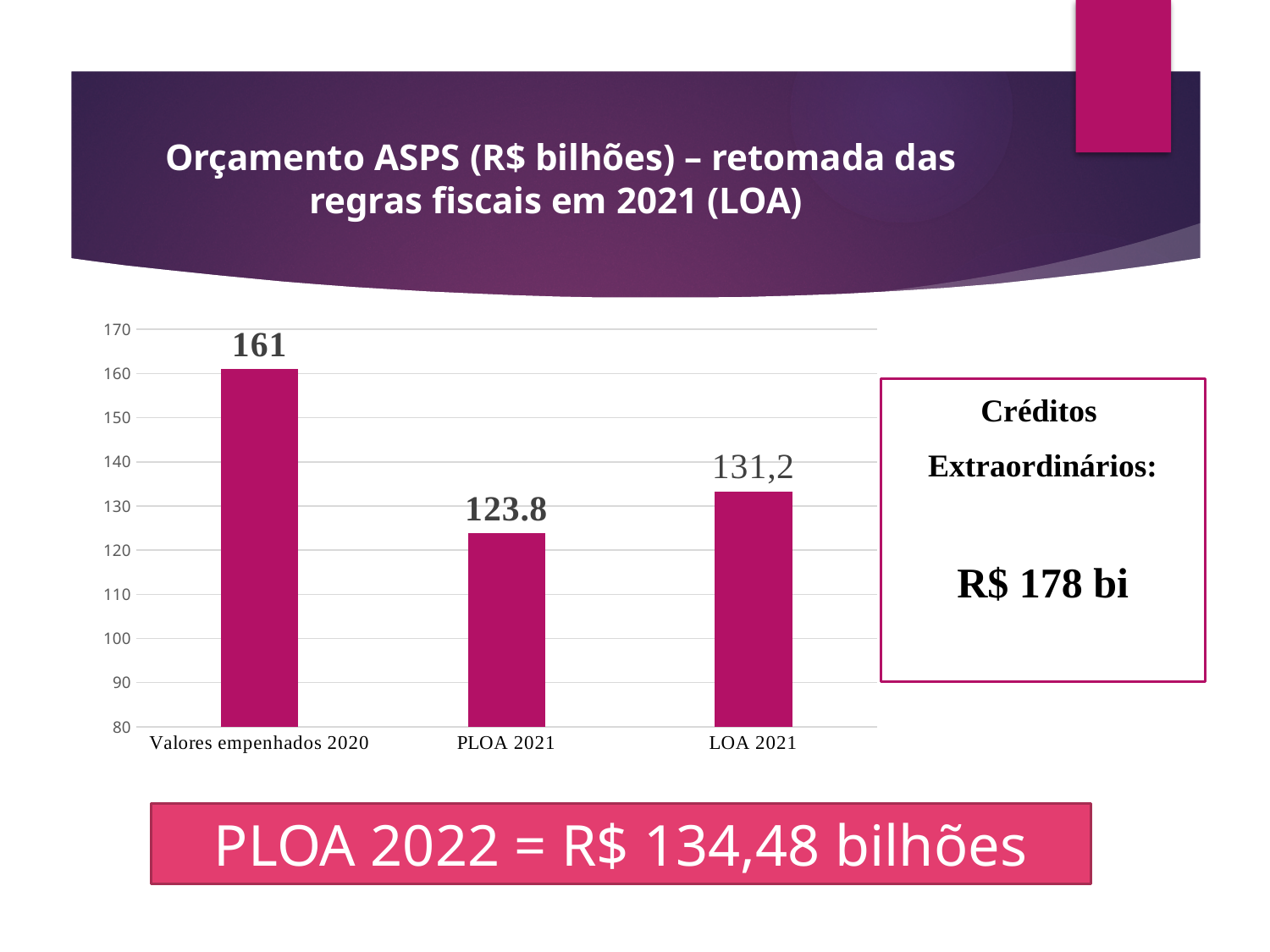
What is the value for PLOA 2021? 123.8 What is the difference between Valores empenhados 2020 and PLOA 2021? 37.2 Is the value for Valores empenhados 2020 greater or less than 150? greater Do the values rise or fall from PLOA 2021 to LOA 2021? rise Which category has the highest value? Valores empenhados 2020 Which category has the lowest value? PLOA 2021 Which is larger, LOA 2021 or PLOA 2021? LOA 2021 What kind of chart is shown on the slide? bar chart What is the value for LOA 2021? 131,2 How many categories are shown on the x axis? 3 What is the value for Valores empenhados 2020? 161 Is the value for LOA 2021 greater or less than 140? less